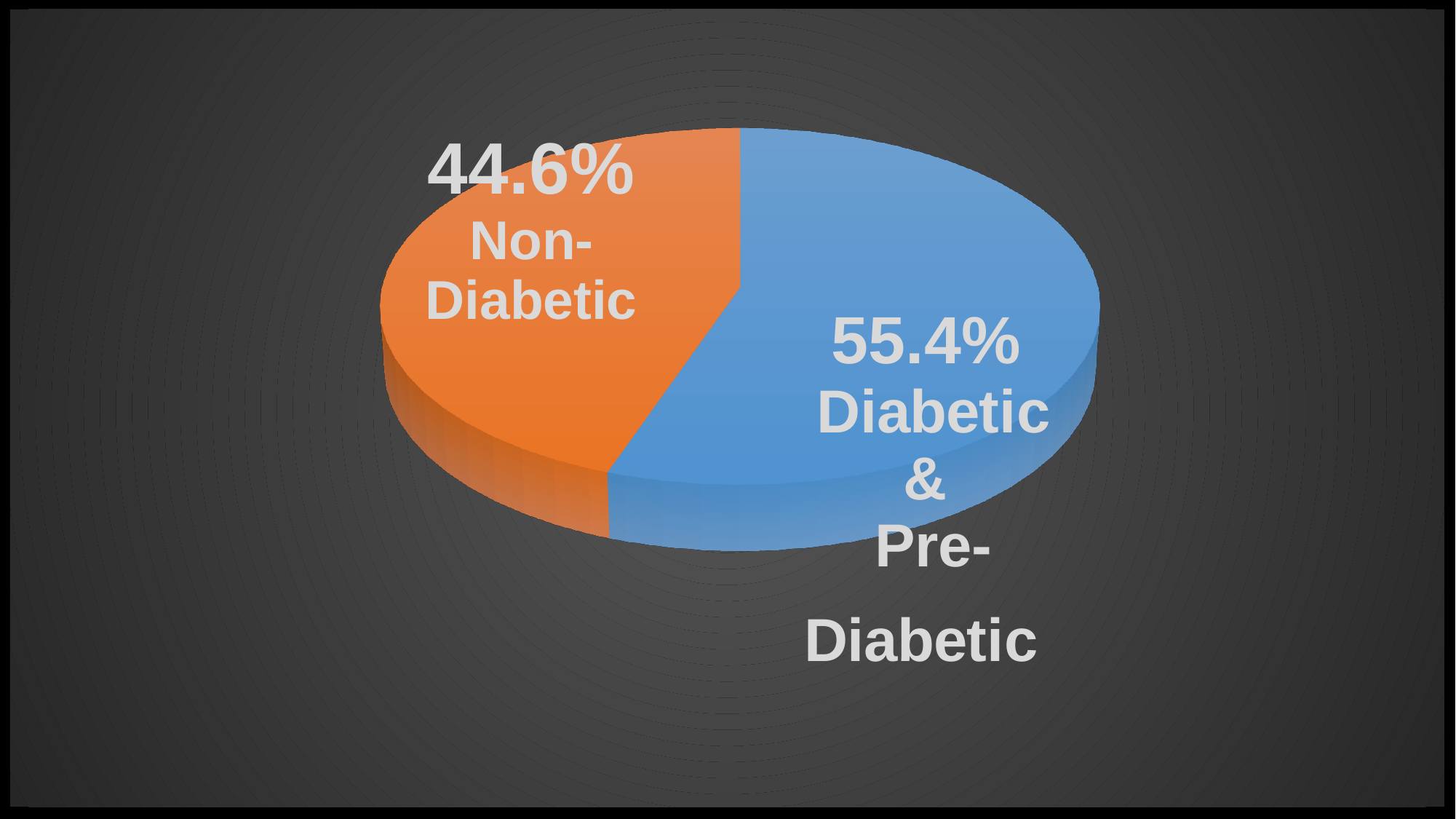
What percentage of the pie is labelled Non-Diabetic? 44.6% Is the Non-Diabetic share greater or less than 50%? less What colour is the Diabetic & Pre-Diabetic slice? Blue What colour is the Non-Diabetic slice? Orange What kind of chart is shown on the slide? Pie chart How many slices does the pie chart have? 2 Which slice of the pie is the smallest? Non-Diabetic Which slice of the pie is the largest? Diabetic & Pre-Diabetic Which is larger, the Non-Diabetic slice or the Diabetic & Pre-Diabetic slice? Diabetic & Pre-Diabetic What is the difference in percentage points between the Diabetic & Pre-Diabetic slice and the Non-Diabetic slice? 10.8 What percentage of the pie is labelled Diabetic & Pre-Diabetic? 55.4%